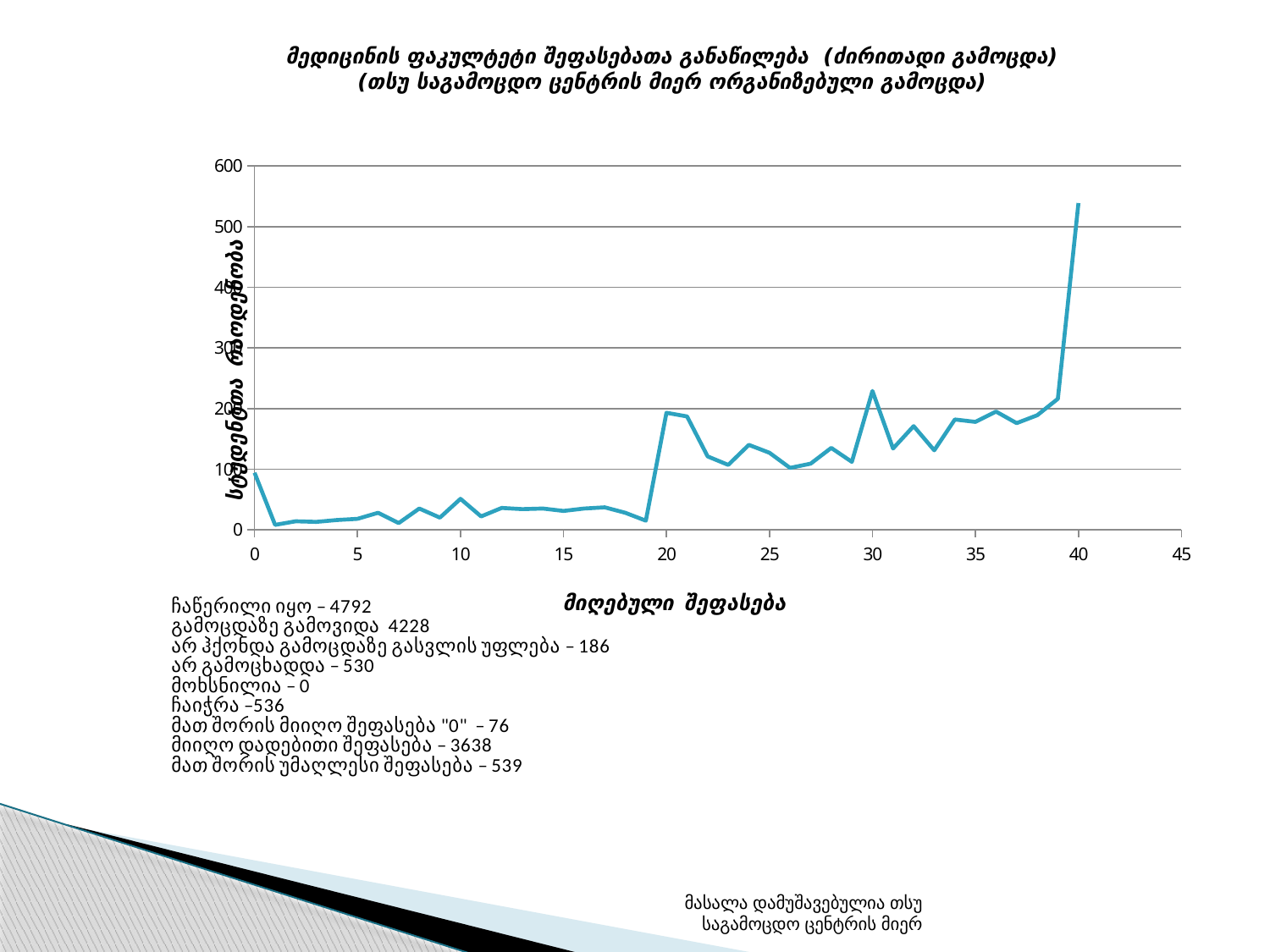
What is the highest tick value shown on the y axis? 600 Is the value at x = 40 greater or less than 500? greater Which is larger, the value at x = 0 or the value at x = 1? x = 0 Is the value at x = 10 greater or less than 100? less Is the value at x = 20 greater or less than 100? greater What kind of chart is shown on the slide? line chart At which x-axis value does the line reach its highest point? 40 What is the label on the x axis of the chart? მიღებული შეფასება Between x = 38 and x = 40, does the line rise or fall? rise